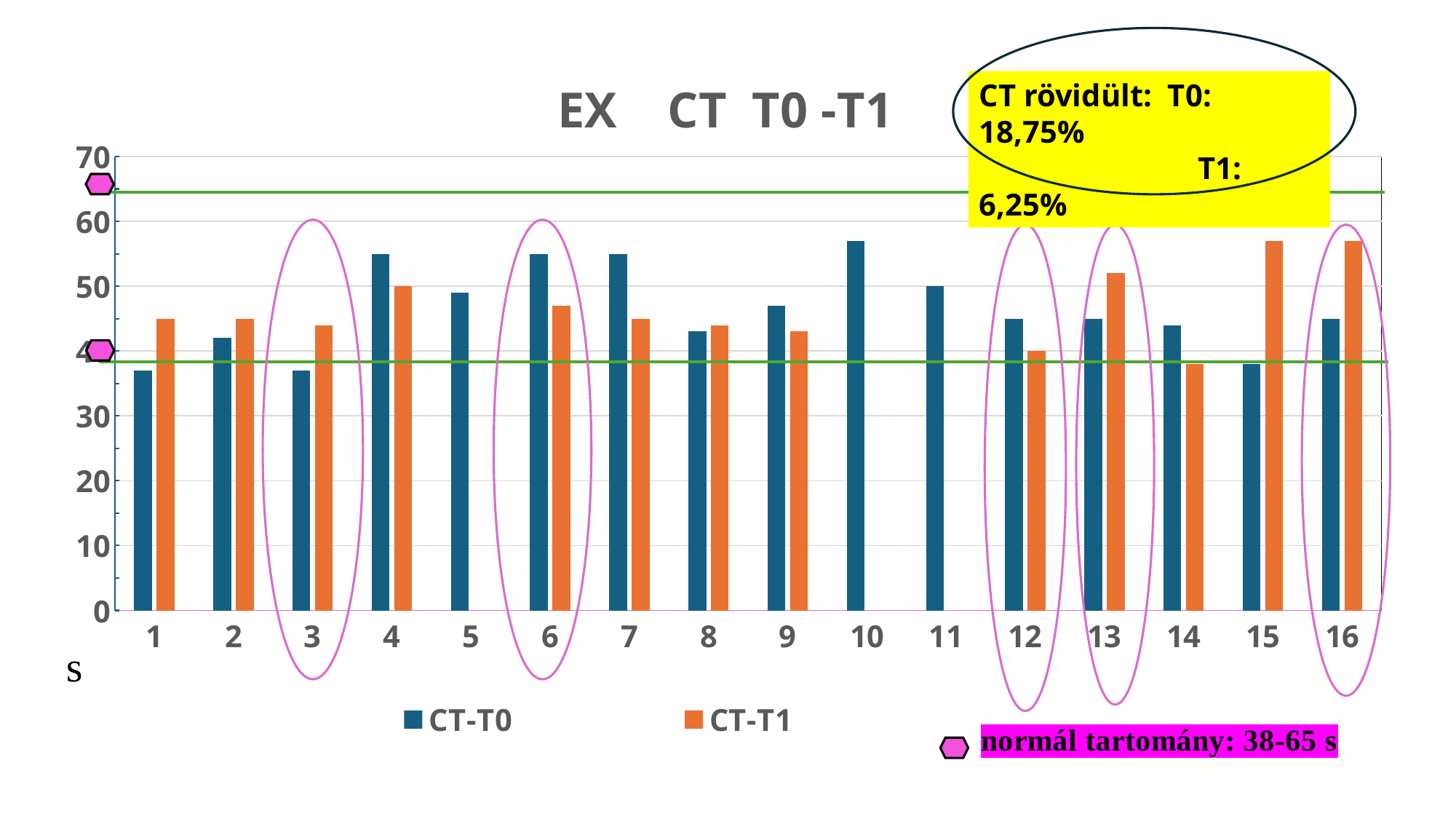
How many series does the legend list? 2 Is the CT-T0 value for category 10 greater or less than 50? greater Is the CT-T1 value for category 13 greater or less than 50? greater What is the title of the chart? EX CT T0 -T1 What kind of chart is shown on the slide? bar chart What are the two legend entries of the chart? CT-T0 and CT-T1 Is the CT-T0 value for category 3 greater or less than 40? less How many categories are shown on the x axis? 16 For category 12, which series has the larger value, CT-T0 or CT-T1? CT-T0 For category 6, which series has the larger value, CT-T0 or CT-T1? CT-T0 For category 13, which series has the larger value, CT-T0 or CT-T1? CT-T1